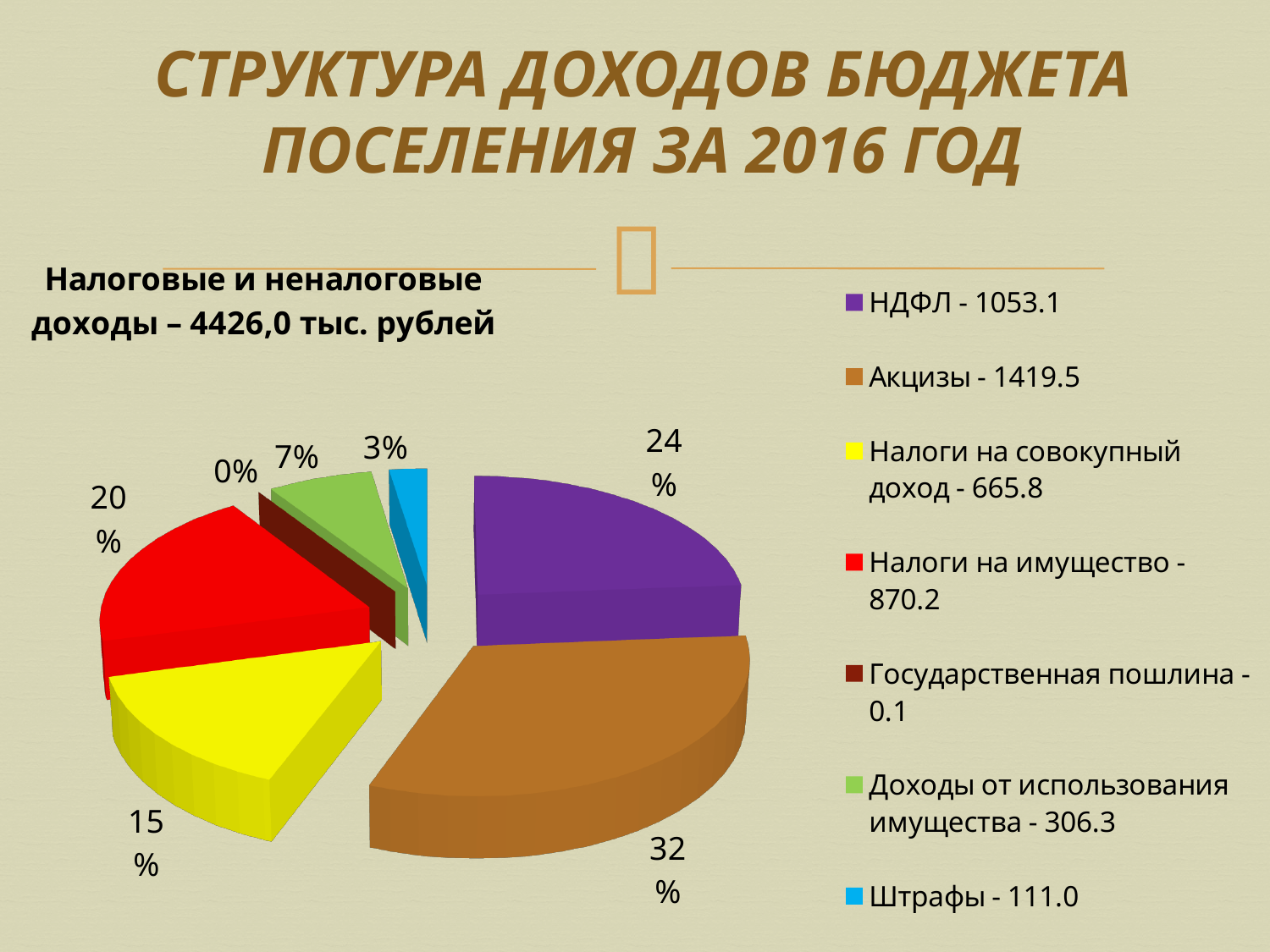
What share of the pie does the НДФЛ slice represent? 24% What share of the pie does the Акцизы slice represent? 32% What is the difference in percentage points between the Акцизы slice and the НДФЛ slice? 8 Which category has the smallest slice of the pie? Государственная пошлина Which slice is larger: Налоги на совокупный доход or Штрафы? Налоги на совокупный доход How many slices does the pie chart have? 7 What share of the pie does the Налоги на имущество slice represent? 20% What value is shown in the legend for Штрафы? 111.0 Which category has the largest slice of the pie? Акцизы What total amount of tax and non-tax revenue is stated in the chart's heading? 4426,0 тыс. рублей What kind of chart is shown on the slide? Pie chart